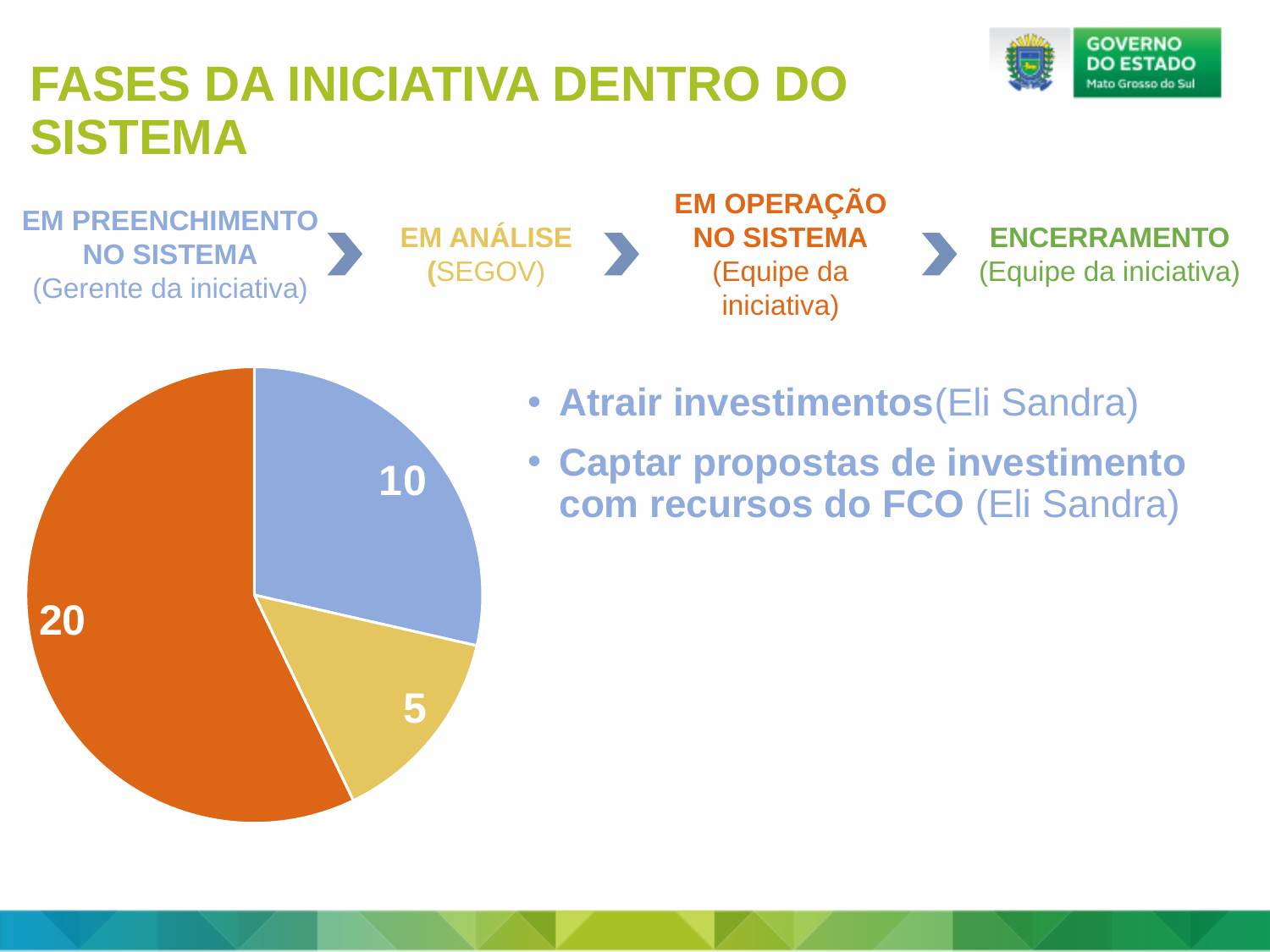
What kind of chart is shown on the slide? pie chart How many slices does the pie chart have? 3 What colour is the largest slice of the pie chart? orange Which slice of the pie chart has the smallest value? the yellow slice (5) What is the difference between the orange slice and the blue slice in the pie chart? 10 What is the value of the yellow slice in the pie chart? 5 What is the total of all the values shown in the pie chart? 35 What is the value of the blue slice in the pie chart? 10 What is the difference between the blue slice and the yellow slice in the pie chart? 5 What is the value of the orange slice in the pie chart? 20 Which is larger in the pie chart, the blue slice or the yellow slice? the blue slice Which slice of the pie chart has the largest value? the orange slice (20)